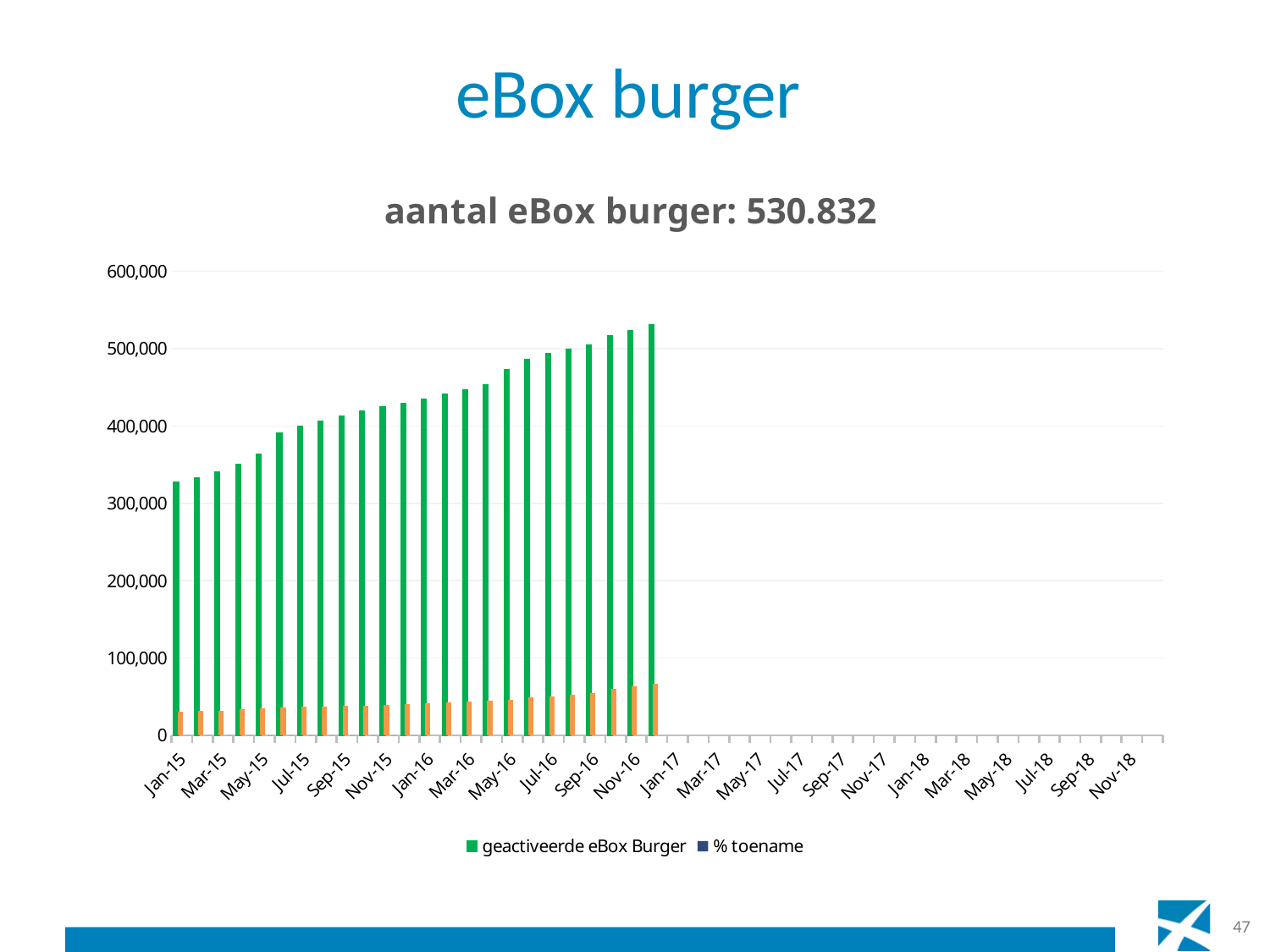
Is the value for geactiveerde eBox Burger in Nov-16 greater or less than 500,000? greater What are the two legend entries of the chart? geactiveerde eBox Burger and % toename Is the shorter orange bar for Nov-16 greater or less than 100,000? less What kind of chart is shown on the slide? bar chart Which labeled month has the lowest geactiveerde eBox Burger value? Jan-15 Is the value for geactiveerde eBox Burger in Jan-15 greater or less than 300,000? greater What is the title of the chart? aantal eBox burger: 530.832 Which is larger, the geactiveerde eBox Burger value for Jan-15 or for Nov-16? Nov-16 How many series does the legend list? 2 Do the green geactiveerde eBox Burger bars rise or fall from Jan-15 to Nov-16? rise